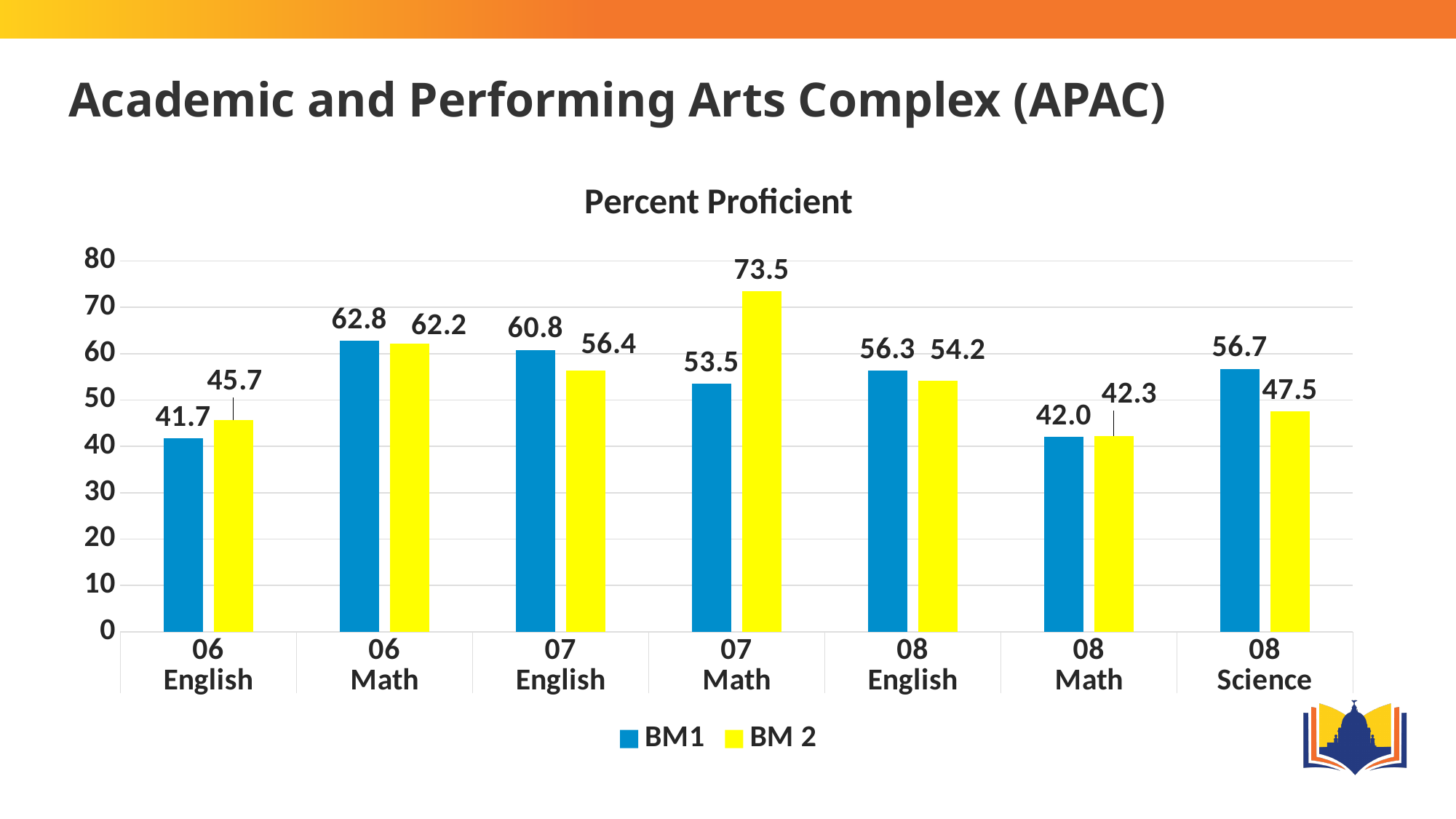
Which is larger for 07 English, BM1 or BM 2? BM1 What is the title of the chart? Percent Proficient How many series does the legend list? 2 What colour are the BM 2 bars? Yellow What is the difference between the BM 2 and BM1 values for 07 Math? 20.0 What is the BM1 value for 08 Science? 56.7 What is the BM 2 value for 07 Math? 73.5 Which category has the highest BM 2 value? 07 Math Which category has the lowest BM1 value? 06 English What kind of chart is shown? Bar chart How many categories are shown on the x axis? 7 What is the BM1 value for 06 English? 41.7